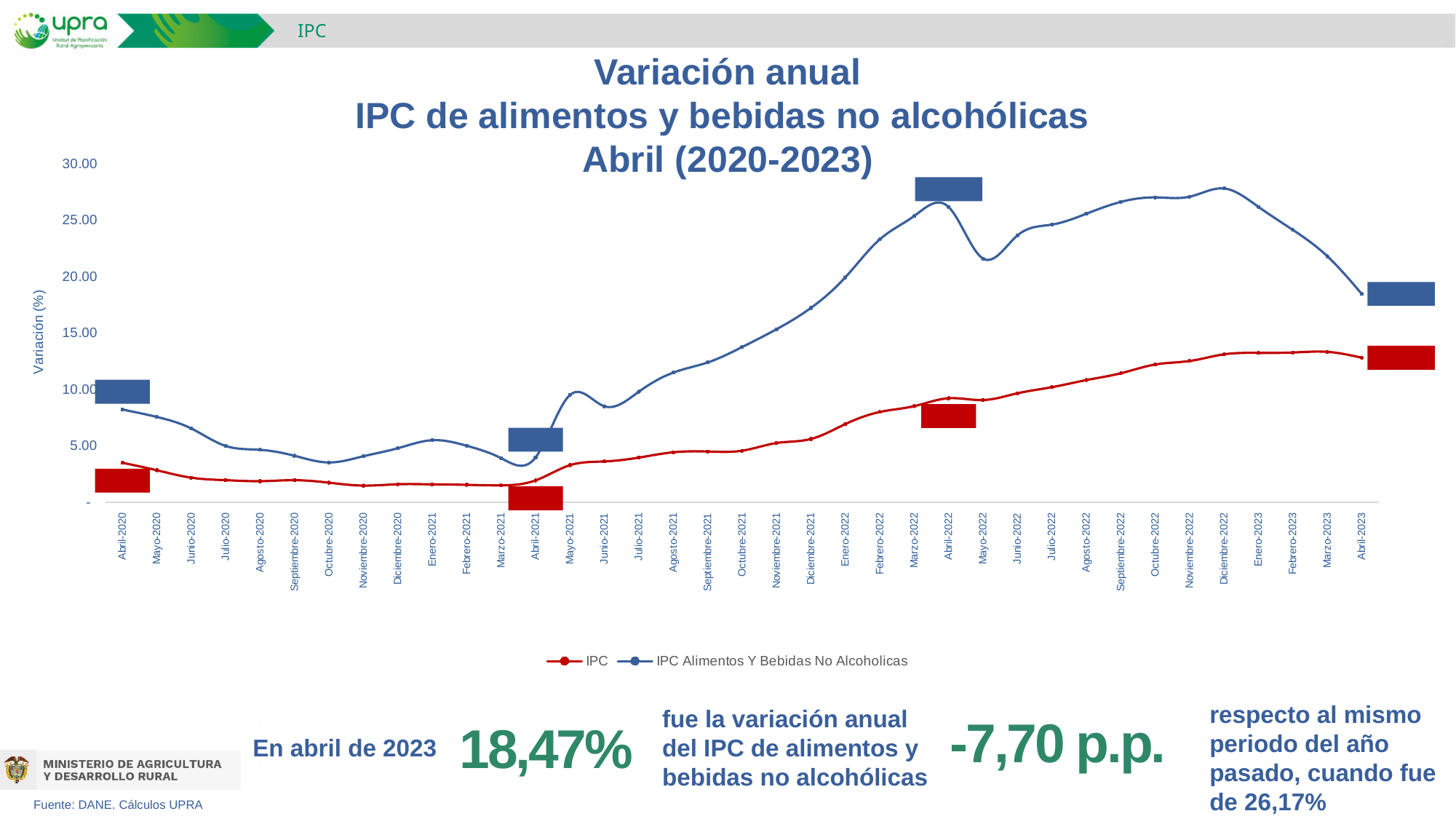
What is the label of the vertical axis of the chart? Variación (%) Does the IPC Alimentos Y Bebidas No Alcoholicas series rise or fall from Diciembre-2022 to Abril-2023? fall By how many percentage points did the annual variation of the IPC de alimentos y bebidas no alcohólicas change between Abril-2022 and Abril-2023? -7,70 p.p. According to the slide, what was the annual variation of the IPC de alimentos y bebidas no alcohólicas in Abril-2022? 26,17% Is the value of IPC Alimentos Y Bebidas No Alcoholicas in Diciembre-2022 greater or less than 25.00? greater What are the two series named in the chart legend? IPC; IPC Alimentos Y Bebidas No Alcoholicas In Abril-2023, which series has the higher value, IPC or IPC Alimentos Y Bebidas No Alcoholicas? IPC Alimentos Y Bebidas No Alcoholicas Is the value of the IPC series in Abril-2023 greater or less than 10.00? greater Is the value of the IPC series in Abril-2020 greater or less than 5.00? less According to the slide, what was the annual variation of the IPC de alimentos y bebidas no alcohólicas in Abril-2023? 18,47% What kind of chart is shown on the slide? line chart How many series does the chart legend list? 2